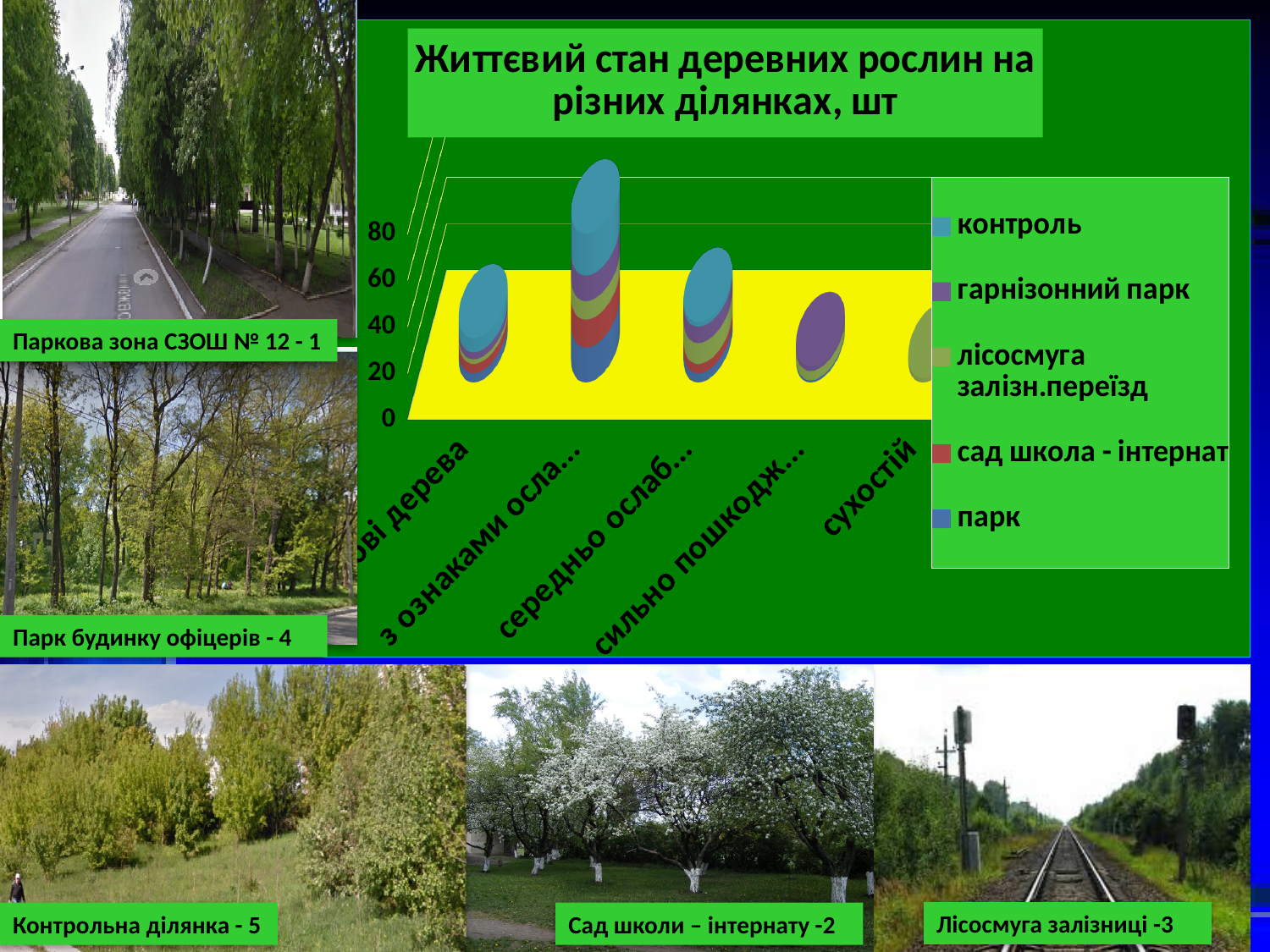
Which is larger: the stacked bar for 'з ознаками осла...' or the stacked bar for 'сильно пошкодж...'? з ознаками осла... How many categories are shown along the x axis of the chart? 5 Which category has the tallest stacked bar in the chart? з ознаками осла... How many series does the chart legend list? 5 What kind of chart is shown on the slide? bar chart Which series is listed first in the chart legend? контроль Is the total stacked value for 'з ознаками осла...' greater or less than 40? greater What is the highest value shown on the vertical axis of the chart? 80 Is the stacked bar for 'сильно пошкодж...' greater or less than 40? less What is the title of the chart? Життєвий стан деревних рослин на різних ділянках, шт